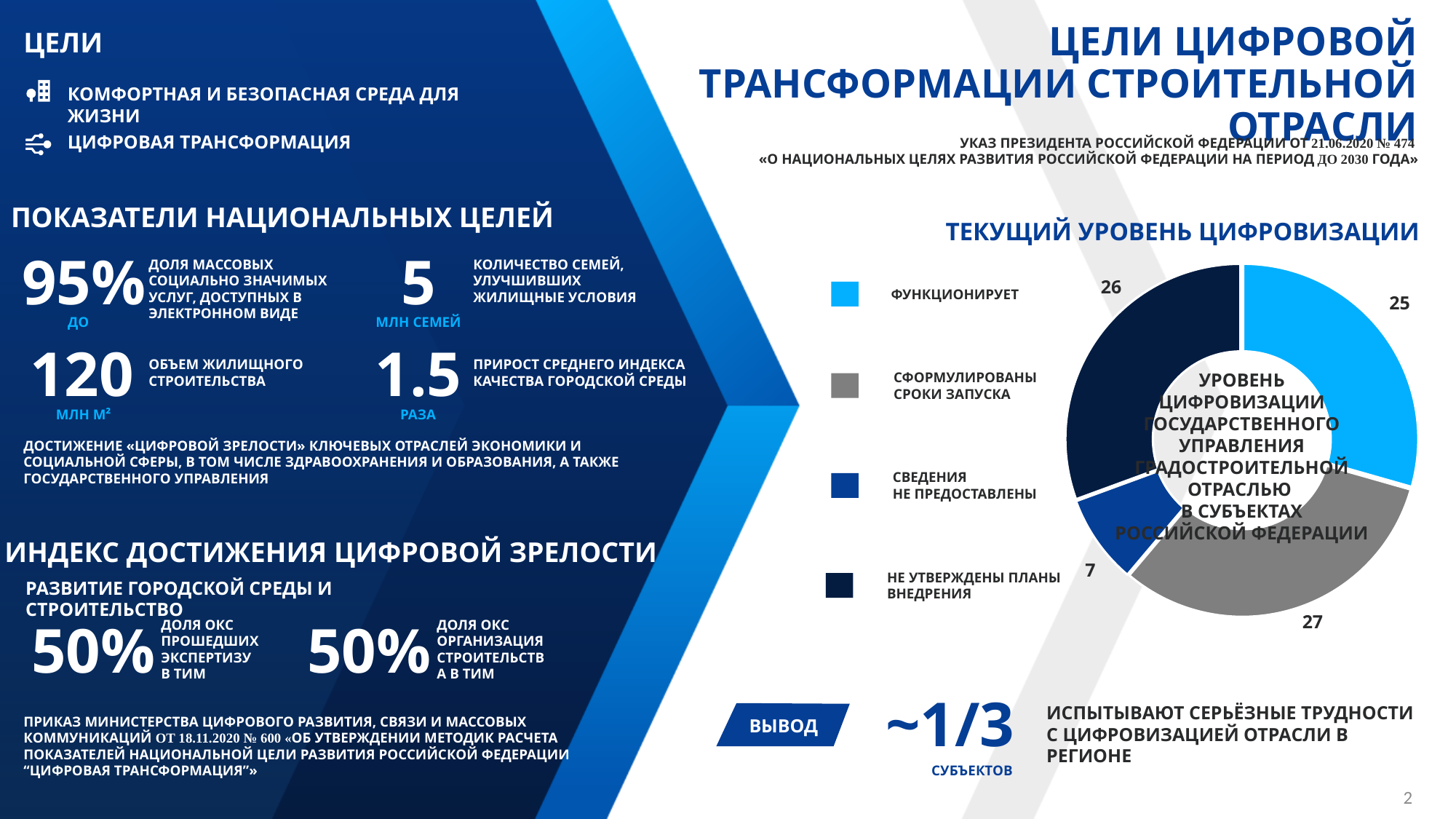
In the donut chart, what is the value for "СВЕДЕНИЯ НЕ ПРЕДОСТАВЛЕНЫ"? 7 In the donut chart, what is the difference between the values for "СФОРМУЛИРОВАНЫ СРОКИ ЗАПУСКА" and "СВЕДЕНИЯ НЕ ПРЕДОСТАВЛЕНЫ"? 20 What kind of chart is shown under the heading "ТЕКУЩИЙ УРОВЕНЬ ЦИФРОВИЗАЦИИ"? Donut (pie) chart In the donut chart, what is the value for "СФОРМУЛИРОВАНЫ СРОКИ ЗАПУСКА"? 27 Which category in the donut chart has the smallest value? СВЕДЕНИЯ НЕ ПРЕДОСТАВЛЕНЫ What colour is the "ФУНКЦИОНИРУЕТ" segment in the donut chart? Light blue In the donut chart, what is the value for "ФУНКЦИОНИРУЕТ"? 25 In the donut chart, which is larger: the value for "ФУНКЦИОНИРУЕТ" or the value for "СВЕДЕНИЯ НЕ ПРЕДОСТАВЛЕНЫ"? ФУНКЦИОНИРУЕТ Which category in the donut chart has the largest value? СФОРМУЛИРОВАНЫ СРОКИ ЗАПУСКА In the donut chart, what is the value for "НЕ УТВЕРЖДЕНЫ ПЛАНЫ ВНЕДРЕНИЯ"? 26 How many categories does the legend of the donut chart list? 4 What is the total of all four values shown in the donut chart? 85